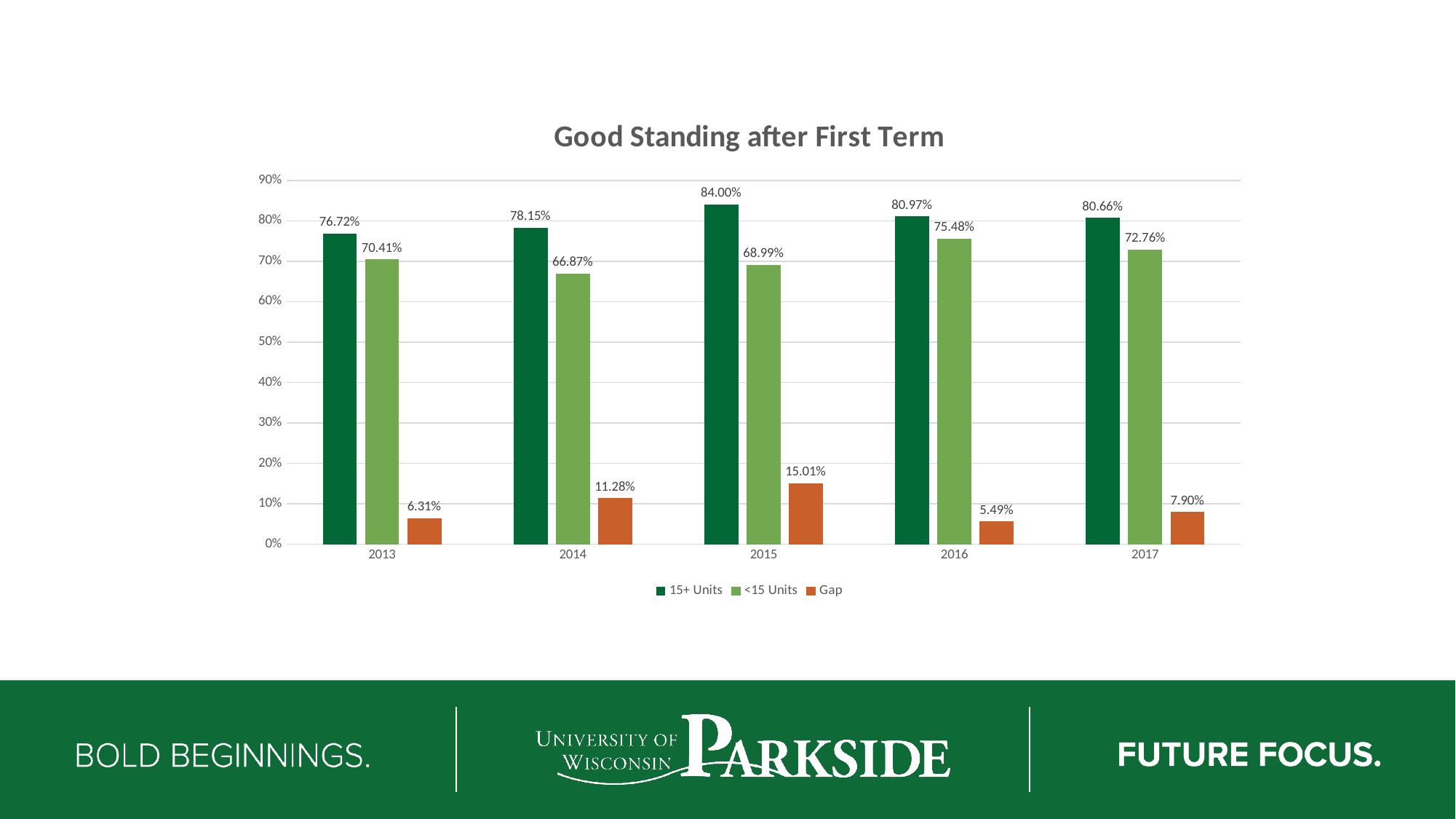
Which year has the highest value for 15+ Units? 2015 How many series does the legend list? 3 What is the value for <15 Units in 2014? 66.87% What is the difference between the 15+ Units and <15 Units values in 2013? 6.31% Which year has the lowest Gap value? 2016 What kind of chart is shown on the slide? Bar chart What is the value for 15+ Units in 2015? 84.00% What is the Gap value for 2017? 7.90% Which is larger in 2016: the value for 15+ Units or the value for <15 Units? 15+ Units Is the Gap value for 2015 greater or less than 10%? greater How many years are shown on the x axis? 5 What is the title of the chart? Good Standing after First Term